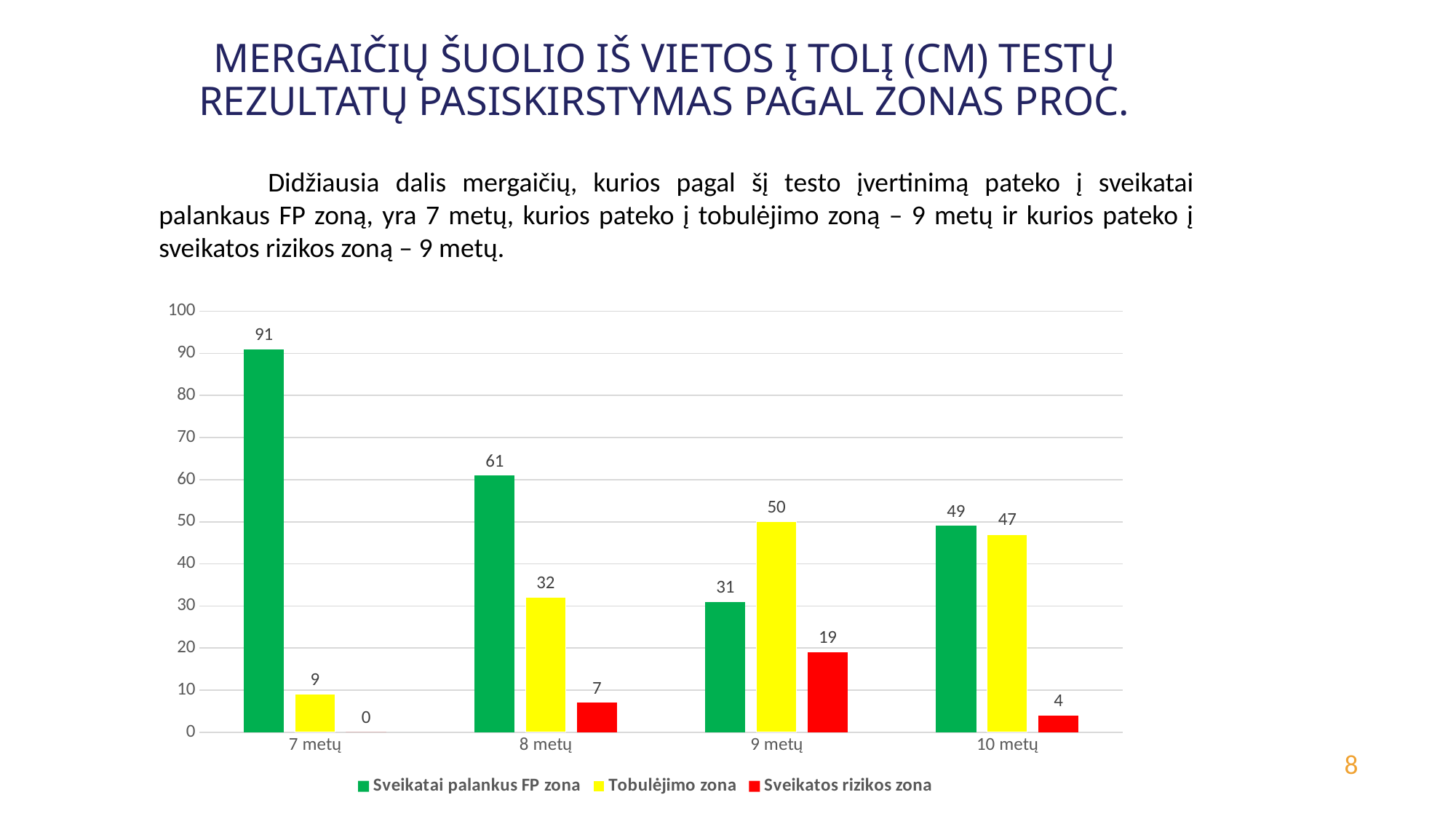
What kind of chart is shown on the slide? Bar chart What is the value for Sveikatos rizikos zona at 8 metų? 7 What is the difference between the Sveikatai palankus FP zona values at 7 metų and 8 metų? 30 Which age group has the lowest value for Sveikatos rizikos zona? 7 metų How many series does the legend list? 3 How many age groups are shown on the x axis? 4 What is the value for Tobulėjimo zona at 9 metų? 50 What colour represents Sveikatos rizikos zona in the legend? Red Do the values for Sveikatai palankus FP zona rise or fall from 7 metų to 9 metų? Fall Which is larger at 10 metų: Sveikatai palankus FP zona or Tobulėjimo zona? Sveikatai palankus FP zona Which age group has the highest value for Sveikatai palankus FP zona? 7 metų What is the value for Sveikatai palankus FP zona at 7 metų? 91